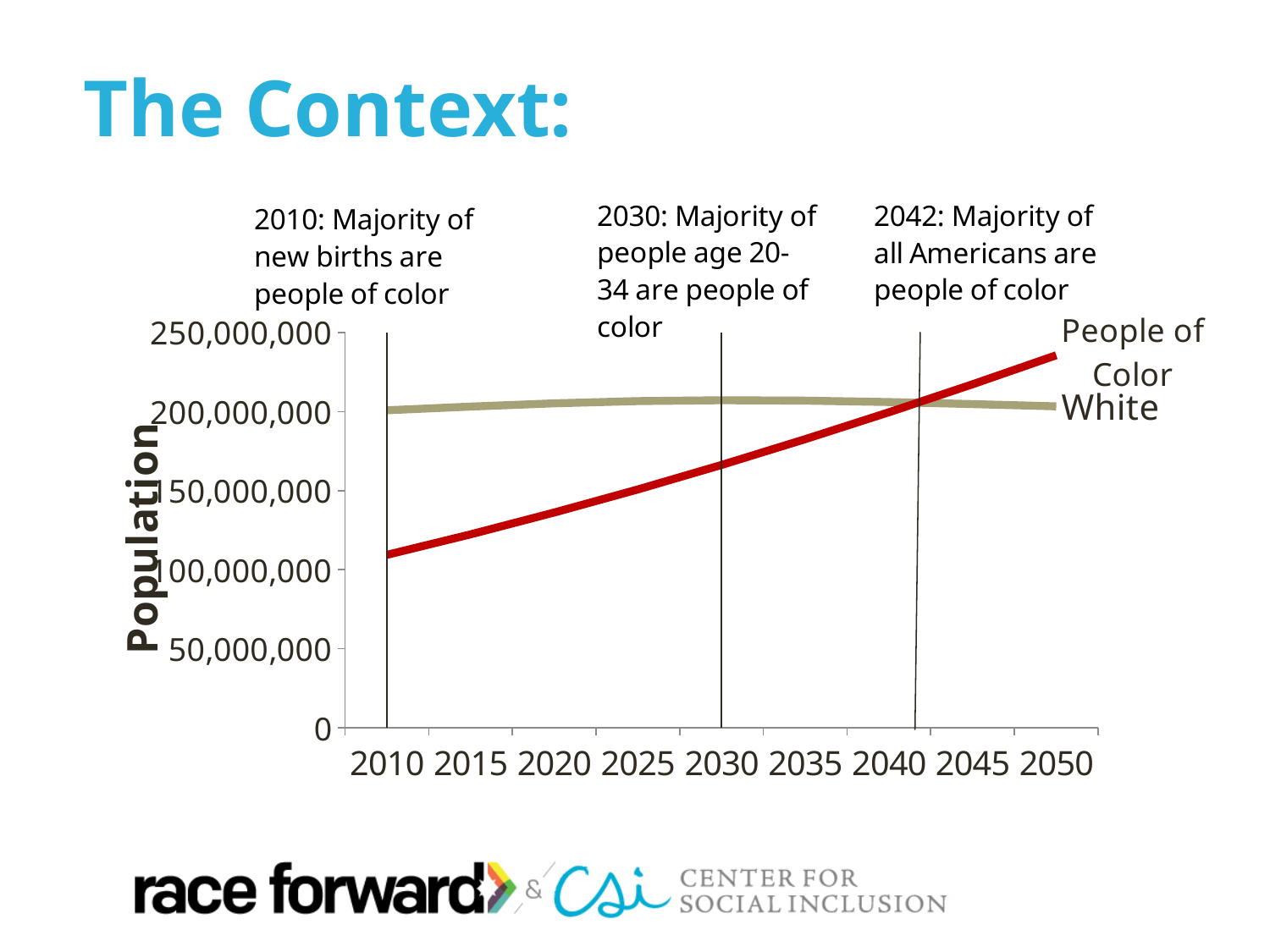
How many series are plotted on the chart? 2 Is the People of Color population in 2050 greater or less than 200,000,000? greater In 2010, which series has the larger population, White or People of Color? White Does the People of Color line rise or fall from 2010 to 2050? rises Is the People of Color population in 2010 greater or less than 150,000,000? less In 2050, which series has the larger population, White or People of Color? People of Color Is the White population in 2010 greater or less than 150,000,000? greater How many year labels are shown on the x axis? 9 What is the label on the vertical axis? Population Which series is drawn in red? People of Color What kind of chart is shown on the slide? line chart